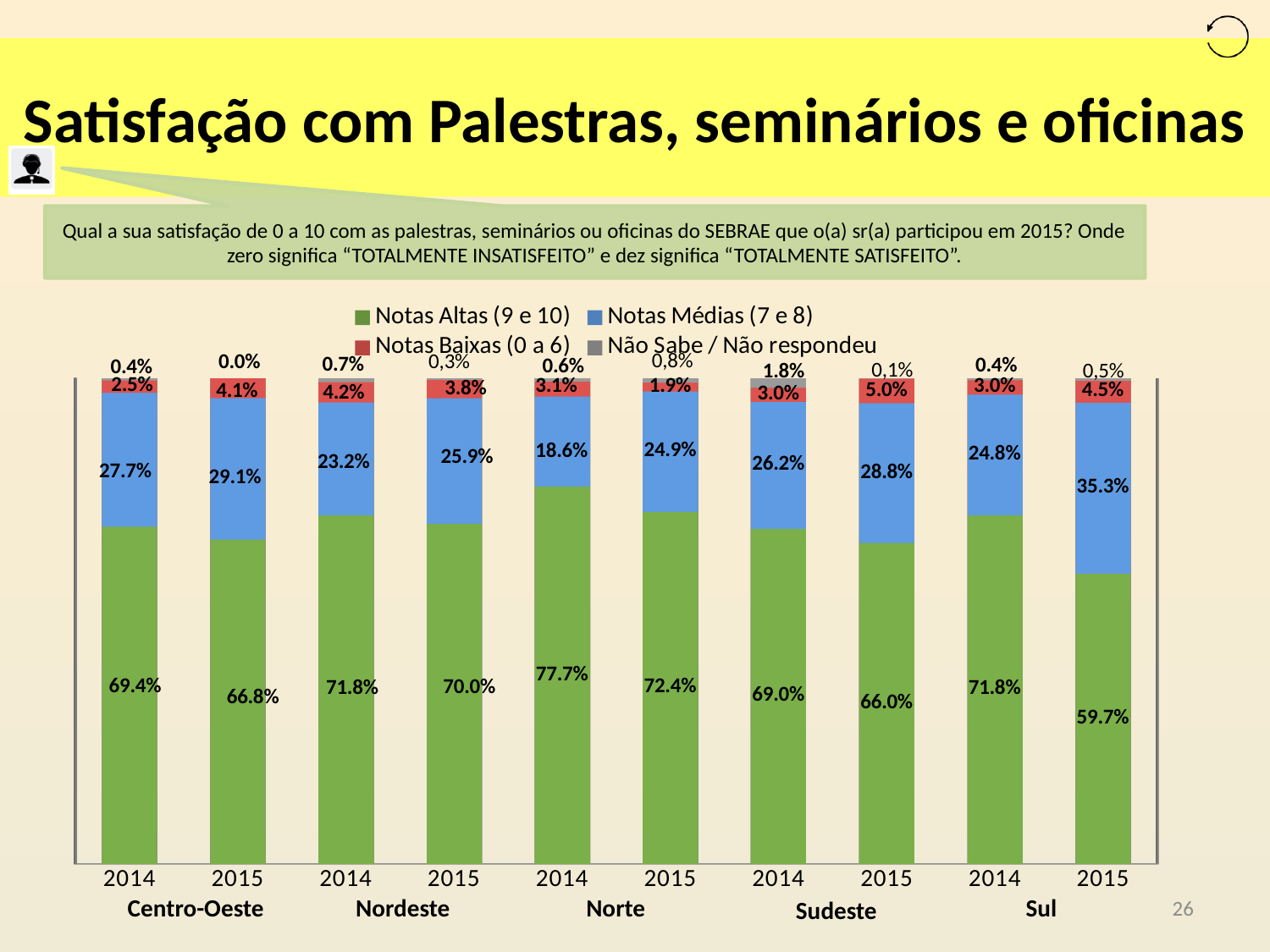
How many bars are plotted in the chart? 10 What is the Não Sabe / Não respondeu value for Sudeste in 2014? 1.8% What is the Notas Baixas (0 a 6) value for Sudeste in 2015? 5.0% Which series is shown in green in the legend? Notas Altas (9 e 10) How many series does the legend list? 4 Which bar has the lowest Notas Altas (9 e 10) value? Sul 2015 What is the Notas Médias (7 e 8) value for Sul in 2015? 35.3% Which bar has the highest Notas Altas (9 e 10) value? Norte 2014 What kind of chart is shown on the slide? Stacked bar chart Which is larger, the Notas Médias (7 e 8) value for Centro-Oeste 2015 or for Nordeste 2015? Centro-Oeste 2015 What is the Notas Altas (9 e 10) value for Norte in 2014? 77.7% What is the difference between the Notas Altas (9 e 10) values for Sul in 2014 and Sul in 2015? 12.1%